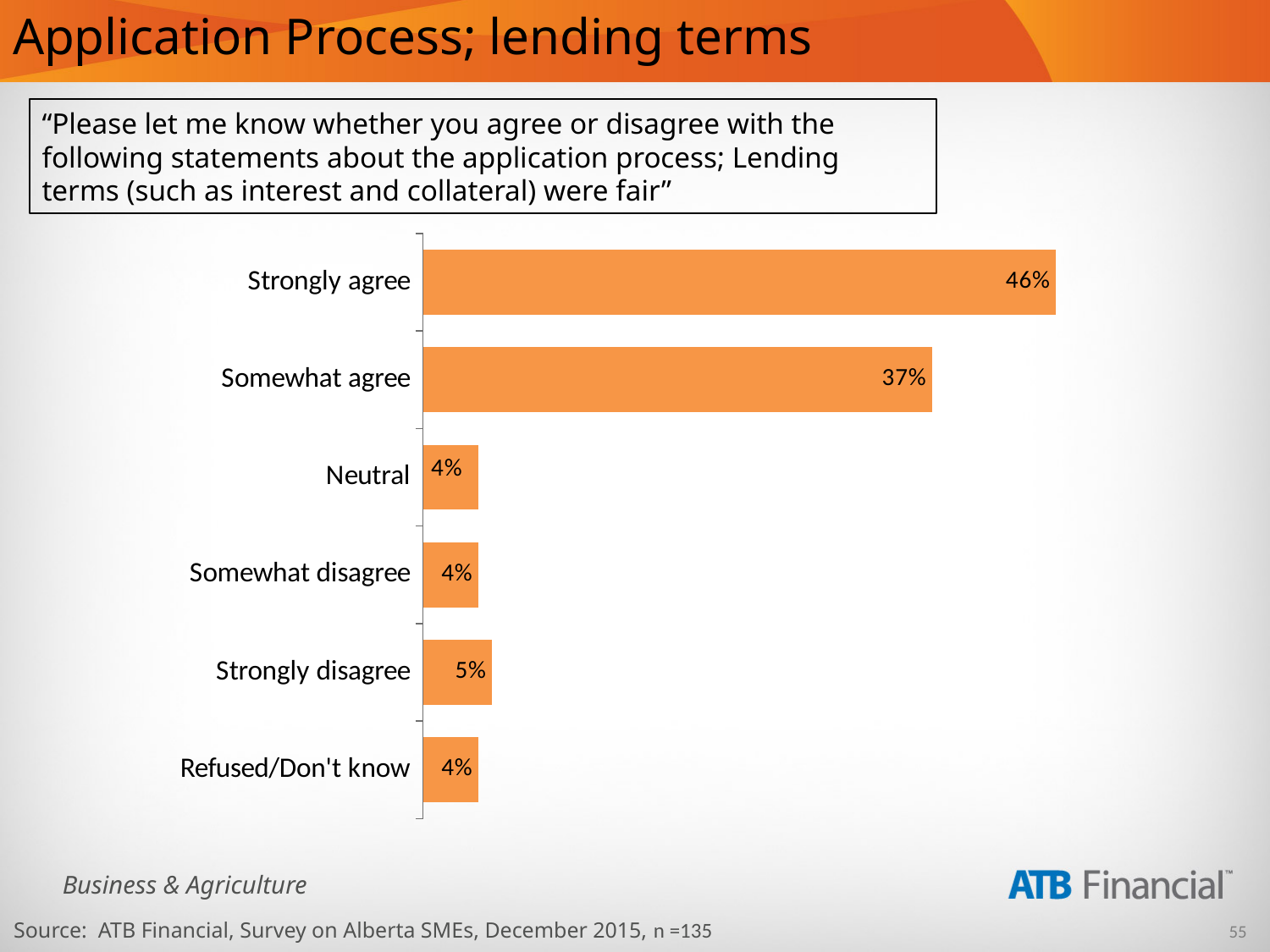
What percentage of respondents answered "Strongly agree"? 46% Which response category has the highest percentage? Strongly agree What is the difference in percentage points between "Strongly agree" and "Somewhat agree"? 9 What colour are the bars in the chart? Orange What is the value shown for "Strongly disagree"? 5% Which is larger, the value for "Strongly disagree" or the value for "Neutral"? Strongly disagree What type of chart is shown on the slide? Bar chart What is the sample size (n) stated in the source line? 135 What is the combined percentage of "Strongly agree" and "Somewhat agree" responses? 83% What is the value shown for "Refused/Don't know"? 4% How many response categories are shown in the chart? 6 What percentage of respondents answered "Somewhat agree"? 37%